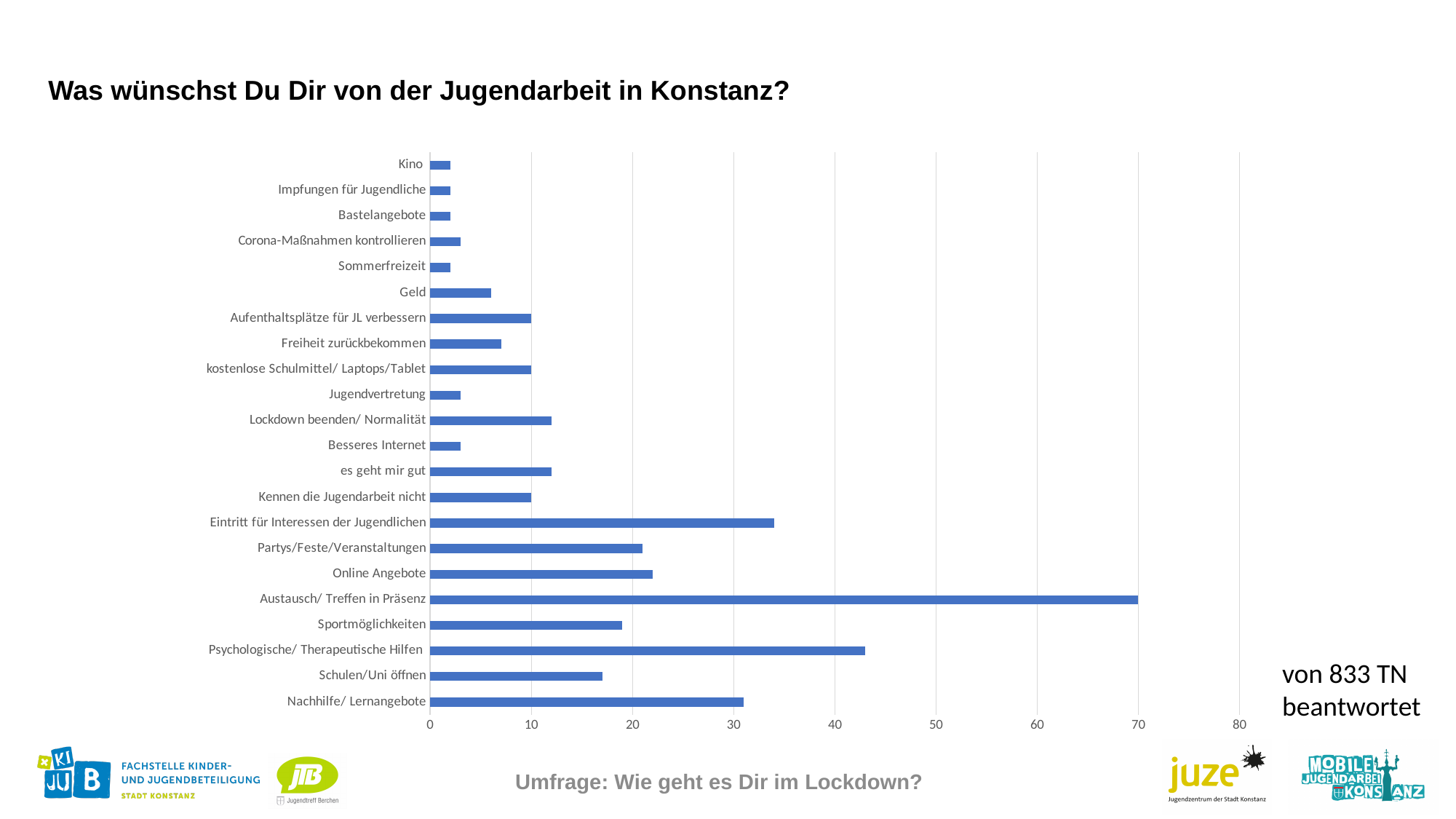
Which is larger: the value for Eintritt für Interessen der Jugendlichen or the value for Partys/Feste/Veranstaltungen? Eintritt für Interessen der Jugendlichen Is the value for Psychologische/ Therapeutische Hilfen greater or less than 40? greater What kind of chart is shown on the slide? bar chart Is the value for Eintritt für Interessen der Jugendlichen greater or less than 40? less What is the title of the slide above the chart? Was wünschst Du Dir von der Jugendarbeit in Konstanz? Which category has the highest value in the chart? Austausch/ Treffen in Präsenz Is the value for Sportmöglichkeiten greater or less than 20? less Which is larger: the value for Psychologische/ Therapeutische Hilfen or the value for Nachhilfe/ Lernangebote? Psychologische/ Therapeutische Hilfen What is the value for Austausch/ Treffen in Präsenz? 70 How many categories are shown in the chart? 22